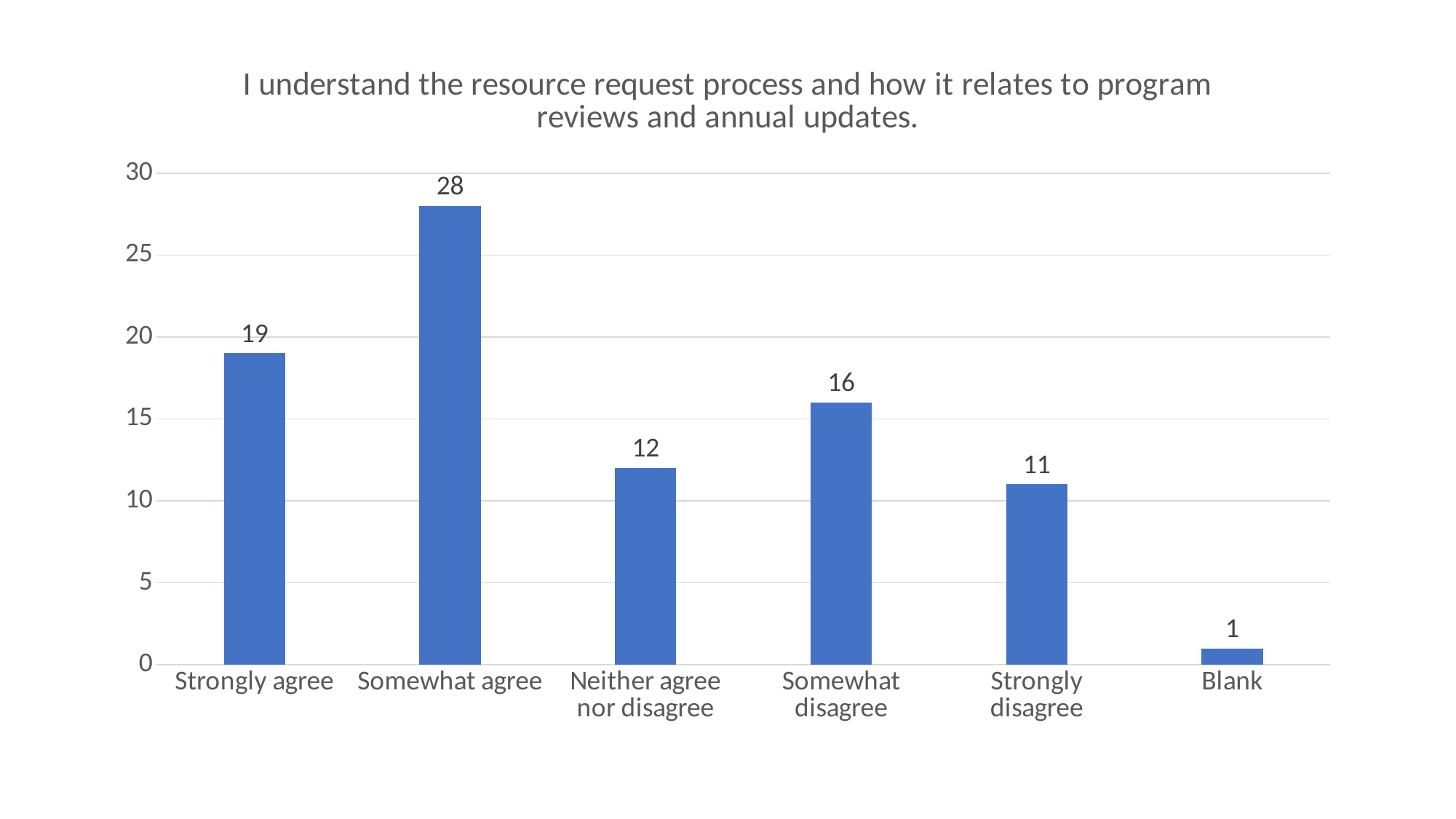
Which category has the lowest value? Blank What is the difference between the values for Somewhat agree and Strongly agree? 9 What kind of chart is shown on the slide? Bar chart What is the title of the chart? I understand the resource request process and how it relates to program reviews and annual updates. Which category has the highest value? Somewhat agree What is the value for Strongly disagree? 11 How many categories are shown on the x axis? 6 What is the value for Somewhat agree? 28 Is the value for Somewhat agree greater or less than 25? greater What is the value for Neither agree nor disagree? 12 Which is larger, the value for Strongly agree or the value for Somewhat disagree? Strongly agree What is the difference between the values for Somewhat disagree and Strongly disagree? 5